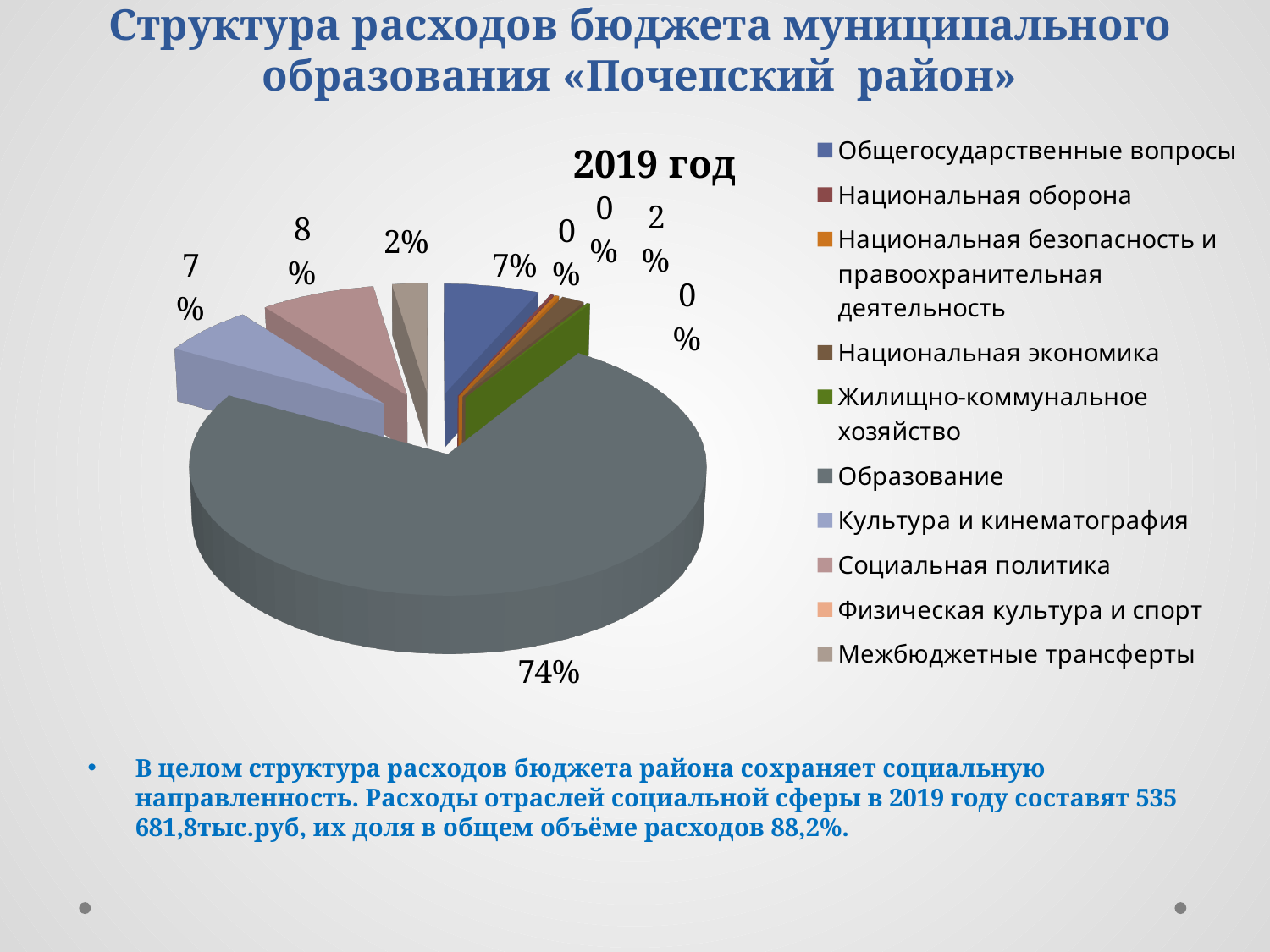
Which category has the largest share of the pie? Образование What share of the pie does Образование have? 74% What kind of chart is shown on the slide? Pie chart Which has the larger share, Образование or Социальная политика? Образование Which has the larger share, Социальная политика or Культура и кинематография? Социальная политика What share of the pie does Межбюджетные трансферты have? 2% What share of the pie does Социальная политика have? 8% What is the title of the chart? 2019 год What is the difference in percentage points between Образование and Социальная политика? 66 How many categories does the legend list? 10 What share of the pie does Общегосударственные вопросы have? 7% What share of the pie does Культура и кинематография have? 7%